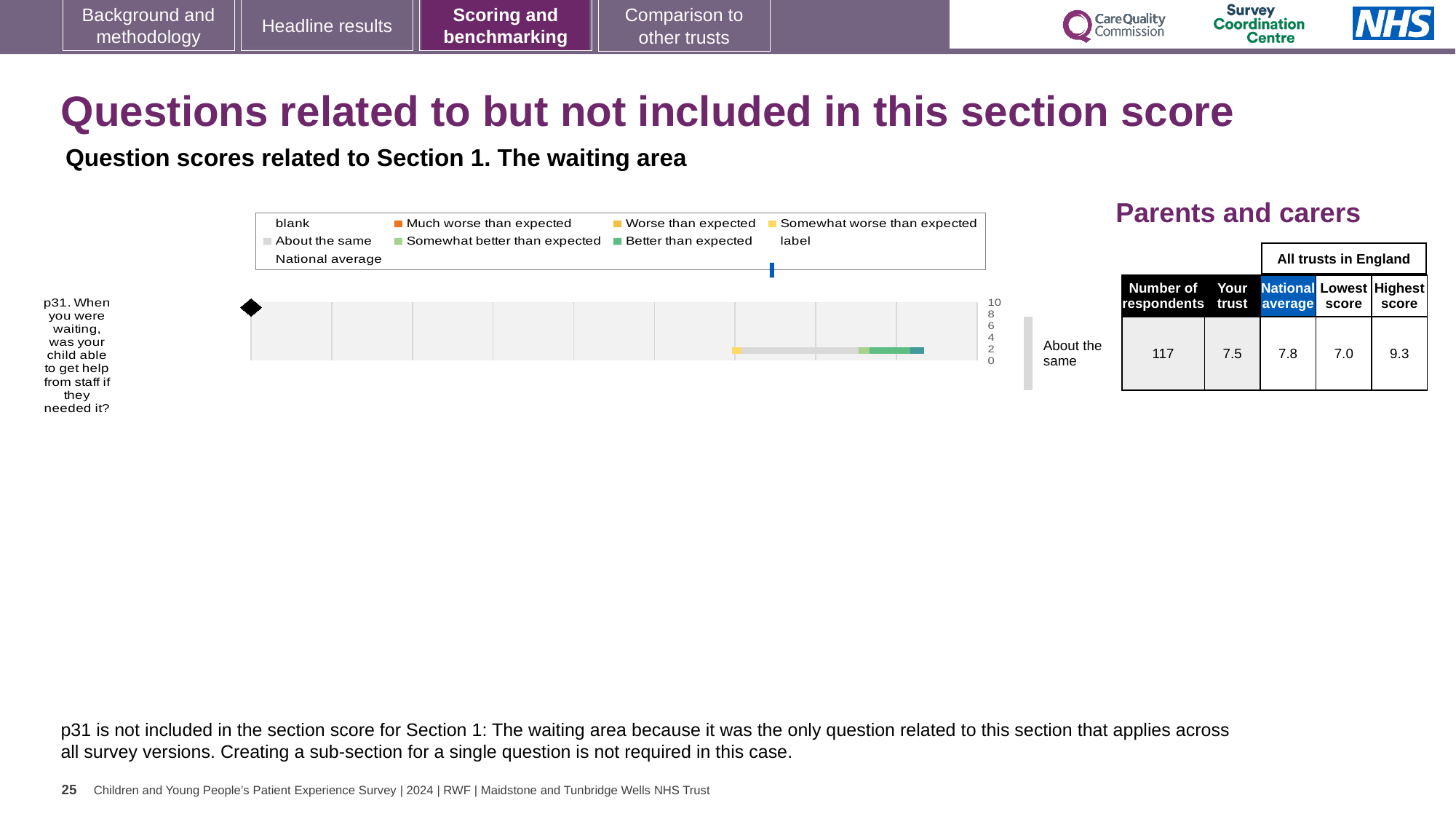
In the table beside the chart, what is the lowest score among all trusts in England for p31? 7.0 In the table beside the chart, what is the national average score for p31? 7.8 What is the highest value shown on the chart's axis? 10 Which survey question is plotted in the chart? p31. When you were waiting, was your child able to get help from staff if they needed it? In the table beside the chart, what is the highest score among all trusts in England for p31? 9.3 What kind of chart is shown on the slide? bar chart What benchmark label is shown to the right of the bar for p31? About the same How many survey questions are plotted in the chart? 1 For p31, what is the difference between the national average (7.8) and the 'Your trust' score (7.5)? 0.3 In the table beside the chart, how many respondents answered p31? 117 In the table beside the chart, what is the 'Your trust' score for p31? 7.5 For p31, which is larger: the 'Your trust' score or the national average? National average